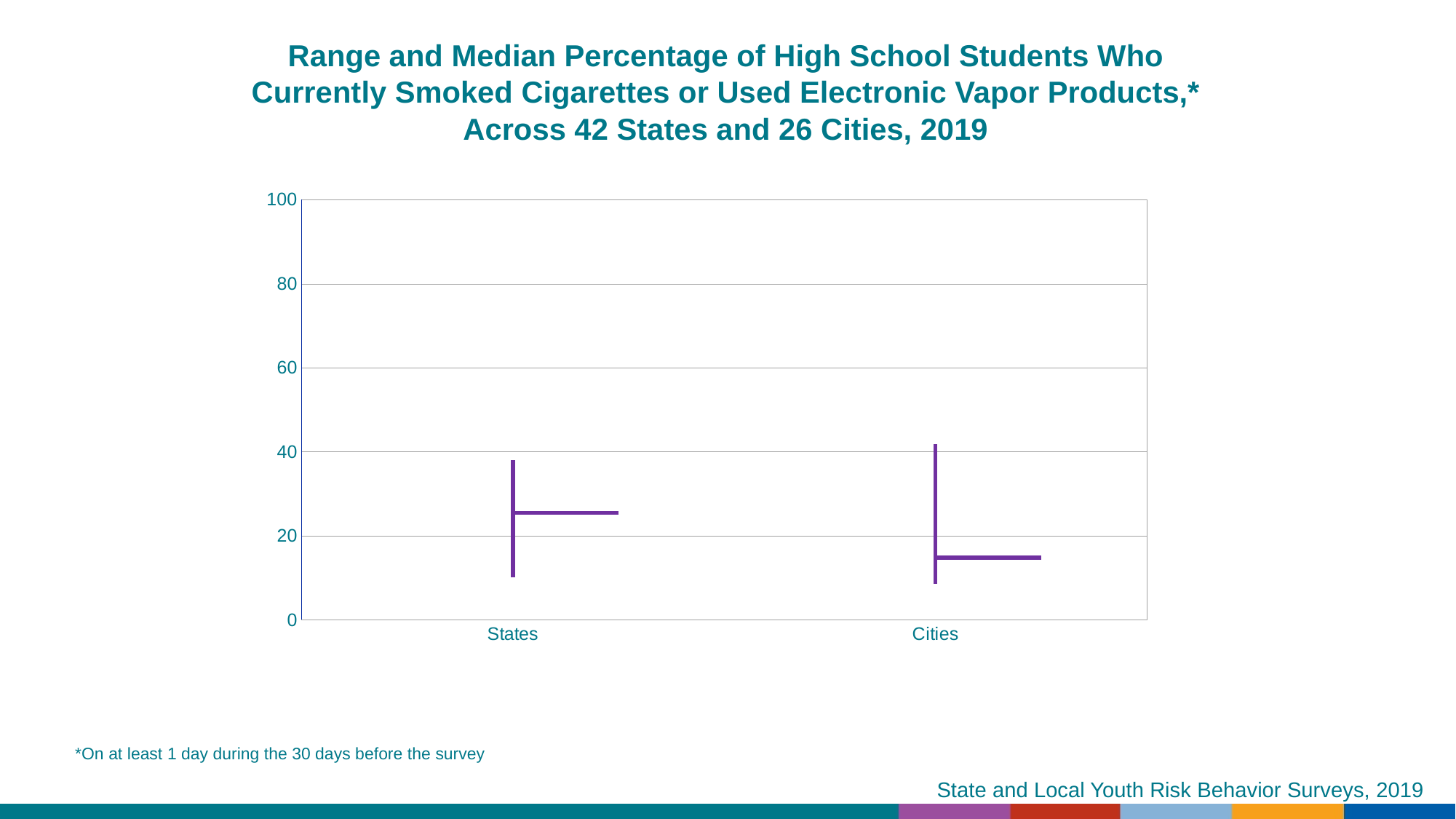
Is the median value for Cities greater or less than 20? less Is the highest value of the range for States greater or less than 60? less What kind of chart is shown on the slide? high-low (range) chart Which category has the higher median value, States or Cities? States Is the median value for States greater or less than 40? less What is the maximum value shown on the y axis? 100 How many categories are shown on the x axis of the chart? 2 Which category has the higher top of its range, States or Cities? Cities What are the two categories shown on the x axis? States and Cities